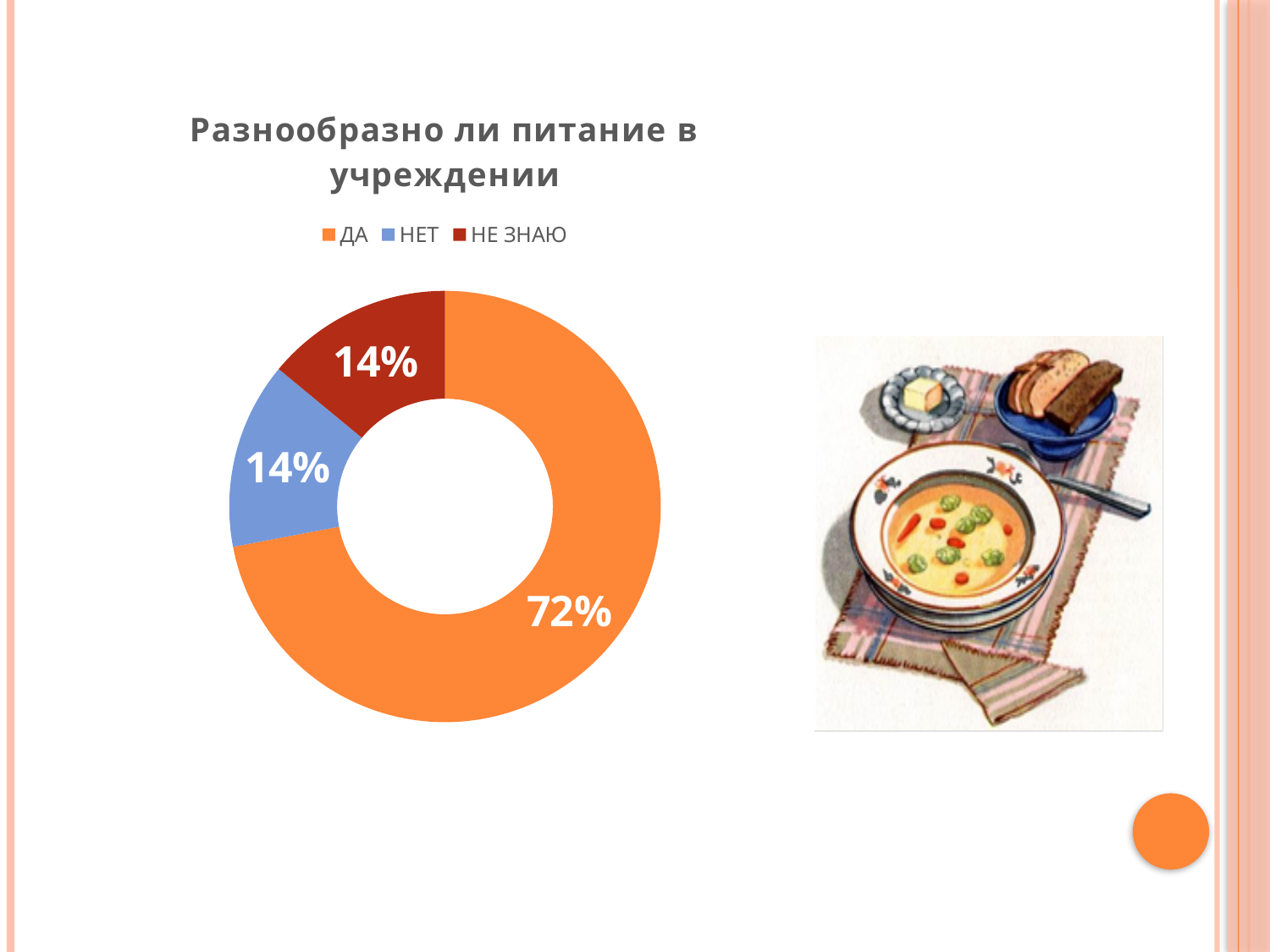
What colour represents ДА in the chart? Orange What share of responses is ДА? 72% Which is larger, the share for ДА or the share for НЕ ЗНАЮ? ДА What share of responses is НЕТ? 14% Which response has the largest share? ДА What kind of chart is shown on the slide? Doughnut (pie) chart What share of responses is НЕ ЗНАЮ? 14% What is the difference in percentage points between ДА and НЕТ? 58 percentage points What is the title of the chart? Разнообразно ли питание в учреждении How many entries does the legend list? 3 How many categories does the chart show? 3 Is the share for ДА greater or less than 50%? greater